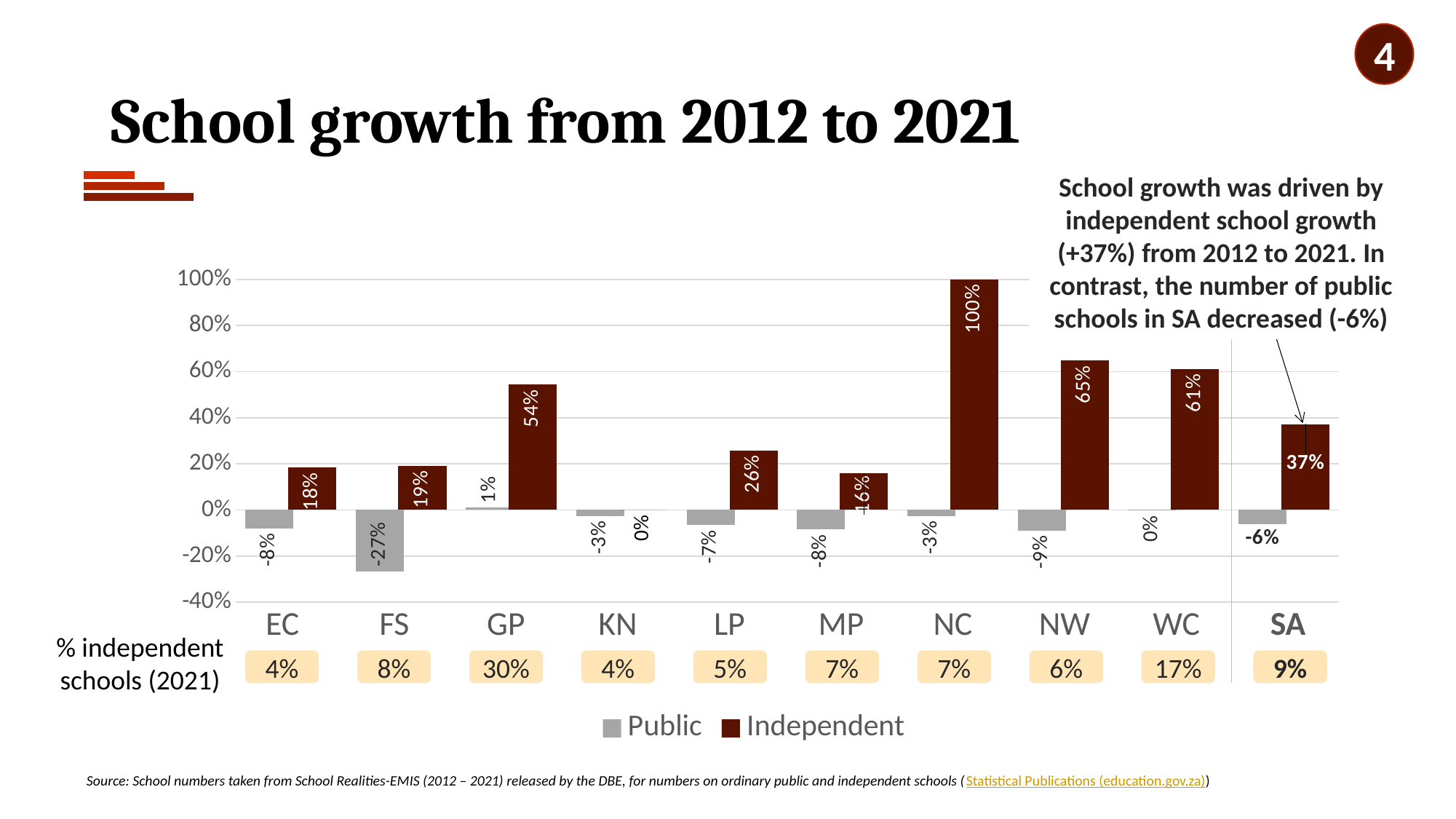
What kind of chart is shown on the slide? Bar chart Which province has the lowest Public school growth? FS What is the Public school growth value for FS? -27% How many provinces/categories are shown on the x axis of the chart? 10 What is the Independent school growth value for GP? 54% What is the % independent schools (2021) value shown for GP? 30% What is the difference between the Independent growth for NW and WC? 4% What is the Public school growth value for SA? -6% Which is larger, the Independent growth for EC or for LP? LP Which province has the highest Independent school growth? NC What is the Independent school growth value for NC? 100% How many series does the legend list? 2